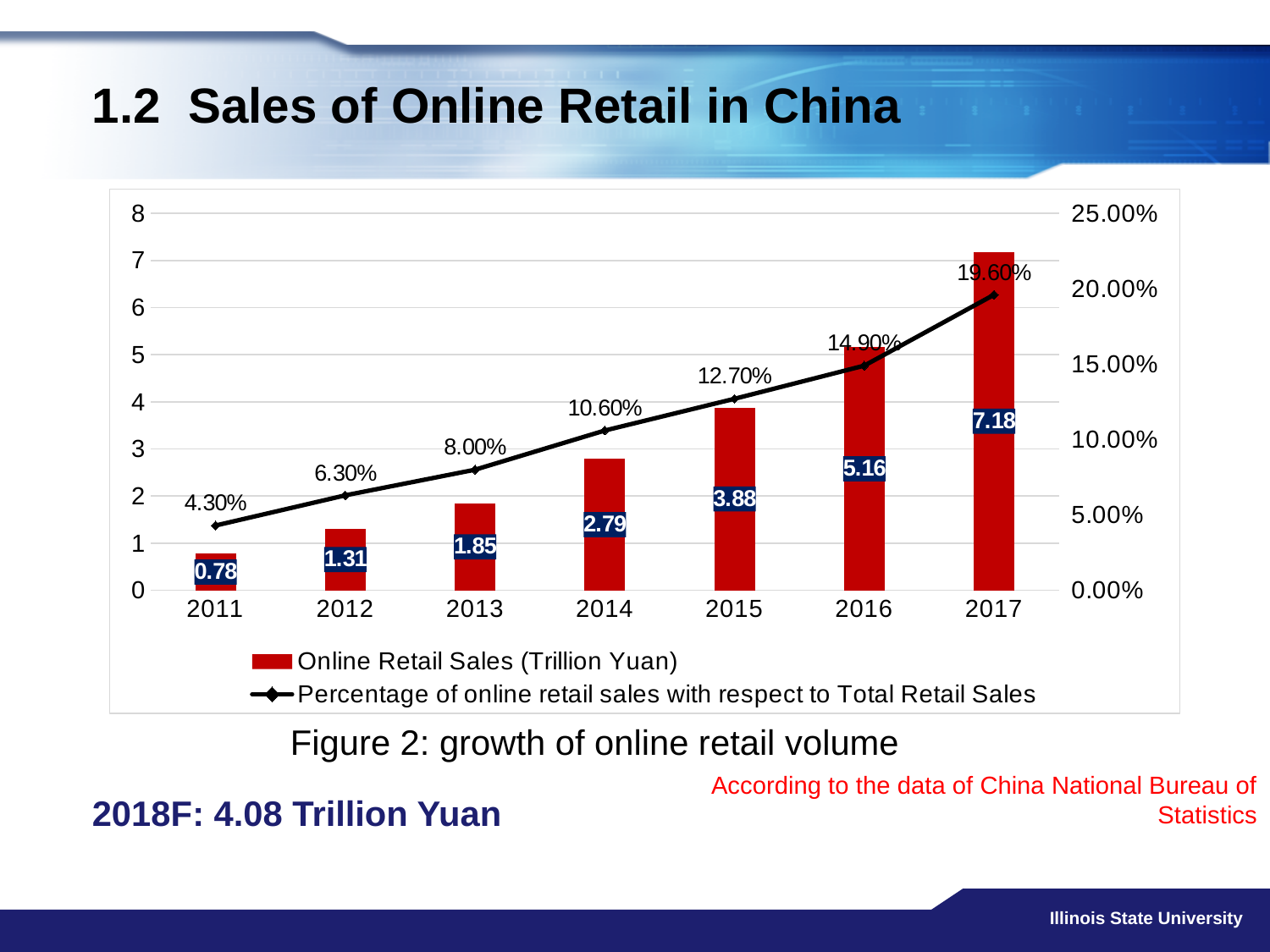
What is the Percentage of online retail sales with respect to Total Retail Sales for 2013? 8.00% Do the Online Retail Sales values rise or fall from 2011 to 2017? rise How many years are shown on the x axis? 7 Which year has a larger Online Retail Sales value, 2012 or 2013? 2013 What is the difference in Online Retail Sales between 2016 and 2015? 1.28 What is the Online Retail Sales value for 2014? 2.79 Which year has the lowest Percentage of online retail sales with respect to Total Retail Sales? 2011 How many series does the legend list? 2 What is the Online Retail Sales value for 2017? 7.18 Which year has the highest Online Retail Sales? 2017 What colour are the Online Retail Sales bars? red Is the Online Retail Sales value for 2016 greater or less than 4? greater